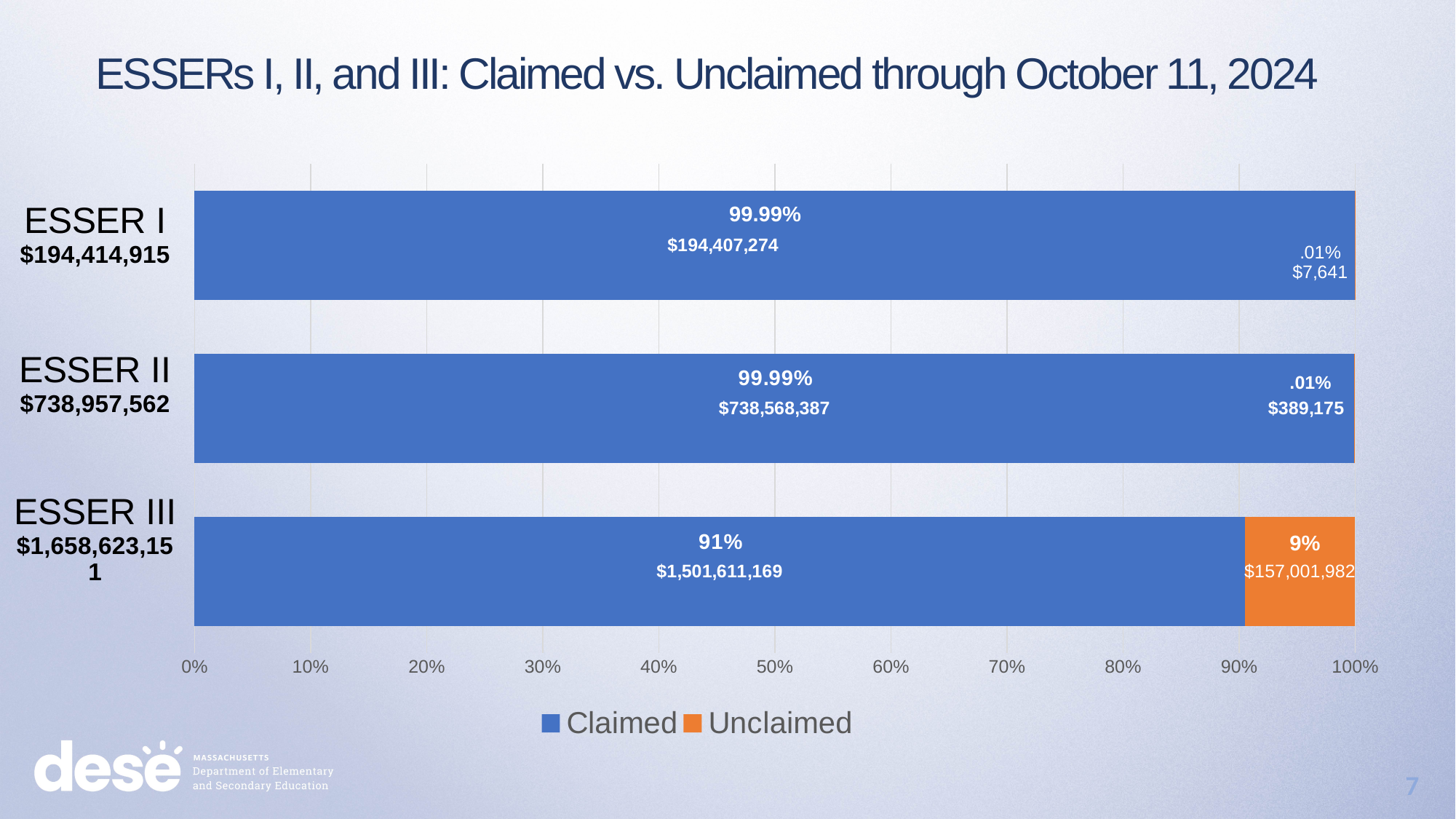
Is the Claimed percentage for ESSER III greater or less than 90%? greater How many series does the legend list? 2 What percentage of ESSER III funds is shown as Claimed? 91% What percentage of ESSER I funds is shown as Unclaimed? .01% Which ESSER program has the highest Unclaimed percentage? ESSER III How many ESSER programs are shown on the chart? 3 What dollar amount is shown as Unclaimed for ESSER I? $7,641 What kind of chart is shown on the slide? Stacked bar chart Which colour represents Unclaimed funds in the chart? Orange Which ESSER program has the lowest Claimed percentage? ESSER III What dollar amount is shown as Unclaimed for ESSER III? $157,001,982 What dollar amount is shown as Claimed for ESSER II? $738,568,387